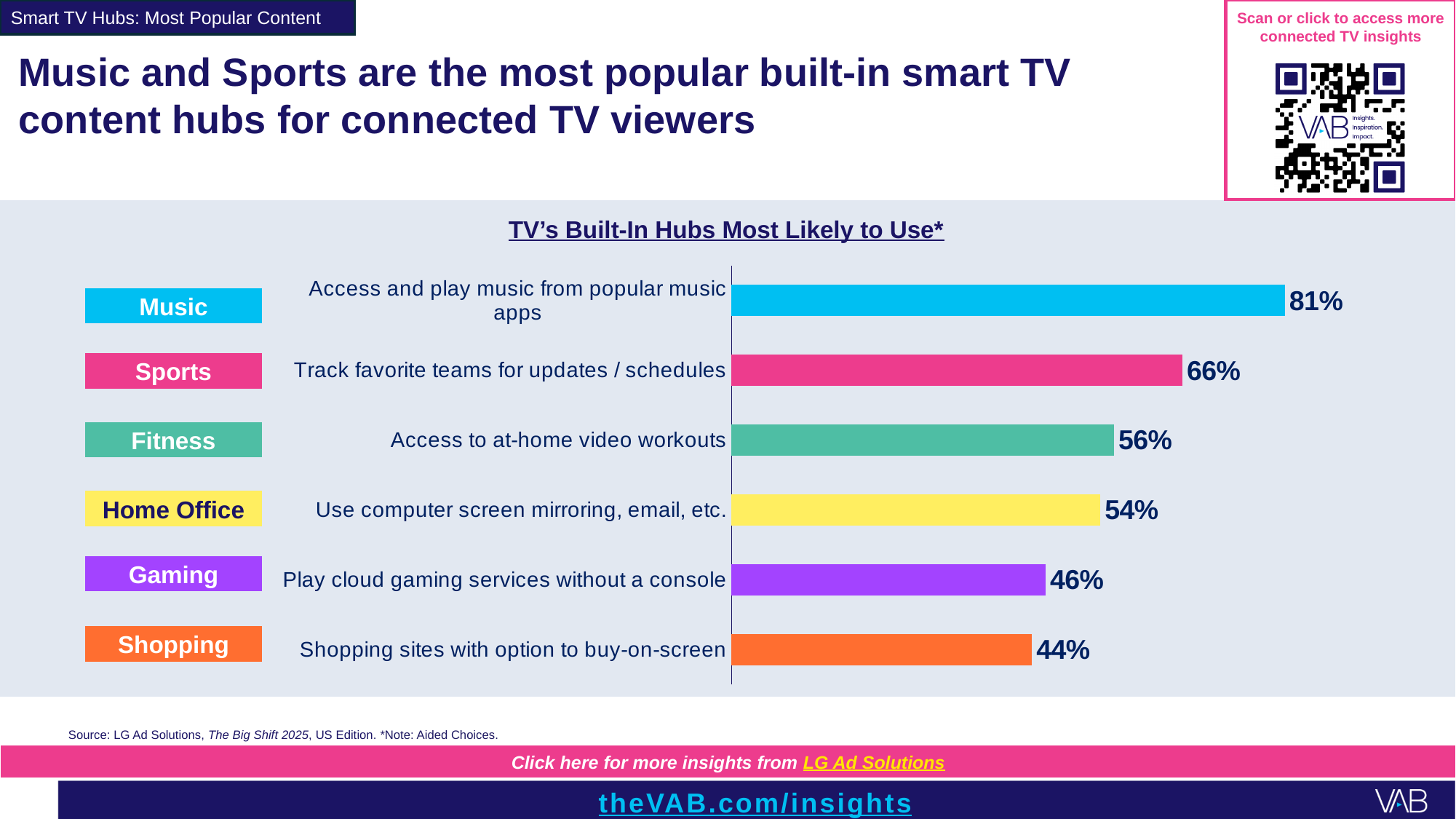
What kind of chart is shown on the slide? Bar chart What is the difference between the values for Fitness and Gaming? 10% What is the value for Music in the chart? 81% What is the value for Home Office in the chart? 54% How many hubs are shown in the chart? 6 Which hub has the lowest value in the chart? Shopping What is the value for Sports in the chart? 66% What is the difference between the values for Music and Sports? 15% What is the title of the chart? TV's Built-In Hubs Most Likely to Use* What is the value for Shopping in the chart? 44% Which hub has the highest value in the chart? Music Which has a larger value, Fitness or Home Office? Fitness